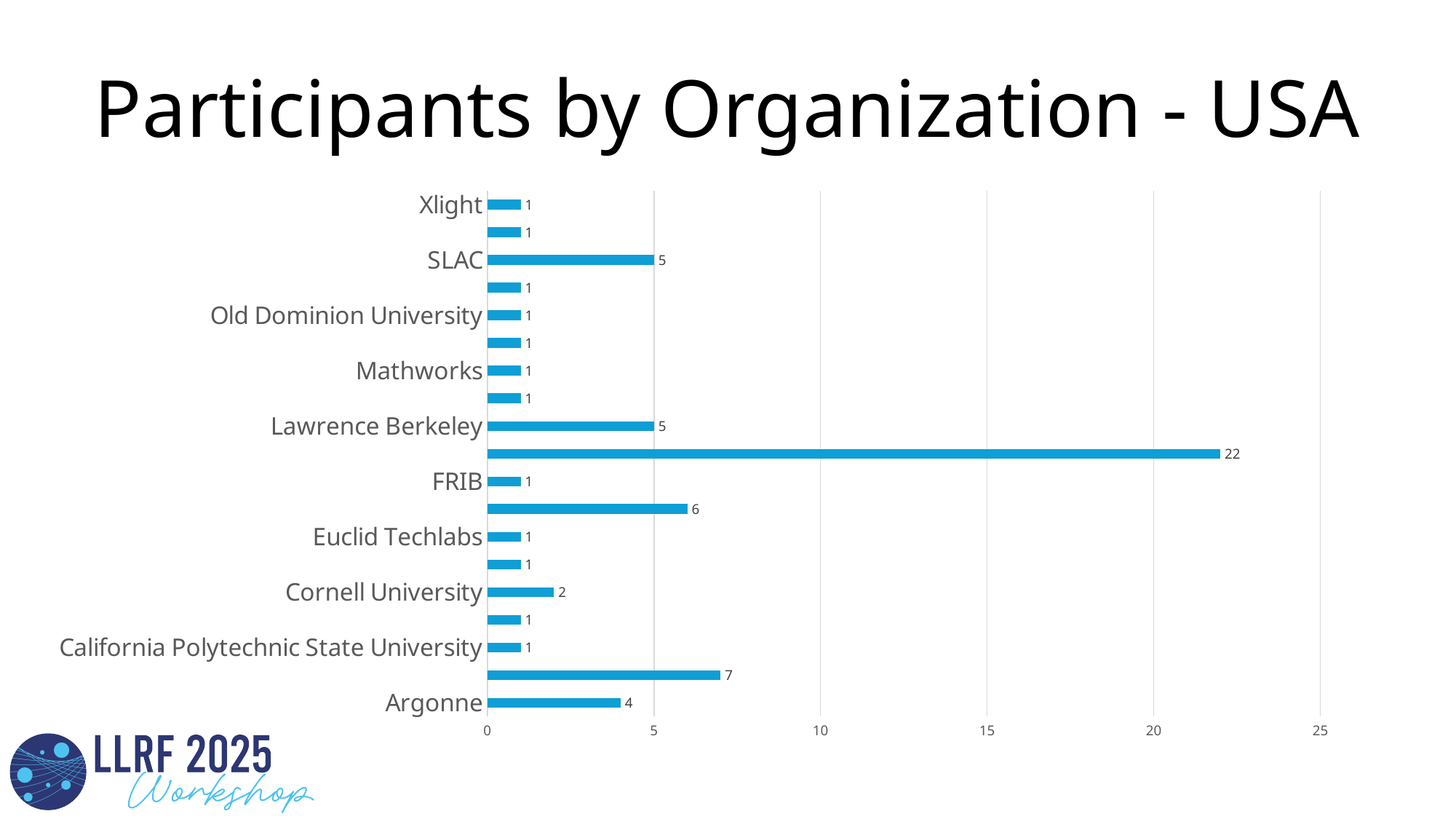
What is the value for Lawrence Berkeley? 5 What is the value for SLAC? 5 What kind of chart is shown on the slide? bar chart What is the value for FRIB? 1 What is the value for Cornell University? 2 Is the value for Lawrence Berkeley greater or less than 10? less Which is larger, the value for Argonne or the value for Cornell University? Argonne What is the value for Argonne? 4 Which is larger, the value for SLAC or the value for Xlight? SLAC What is the difference between the values for Argonne and Cornell University? 2 What is the title of the chart? Participants by Organization - USA What is the difference between the values for SLAC and Argonne? 1